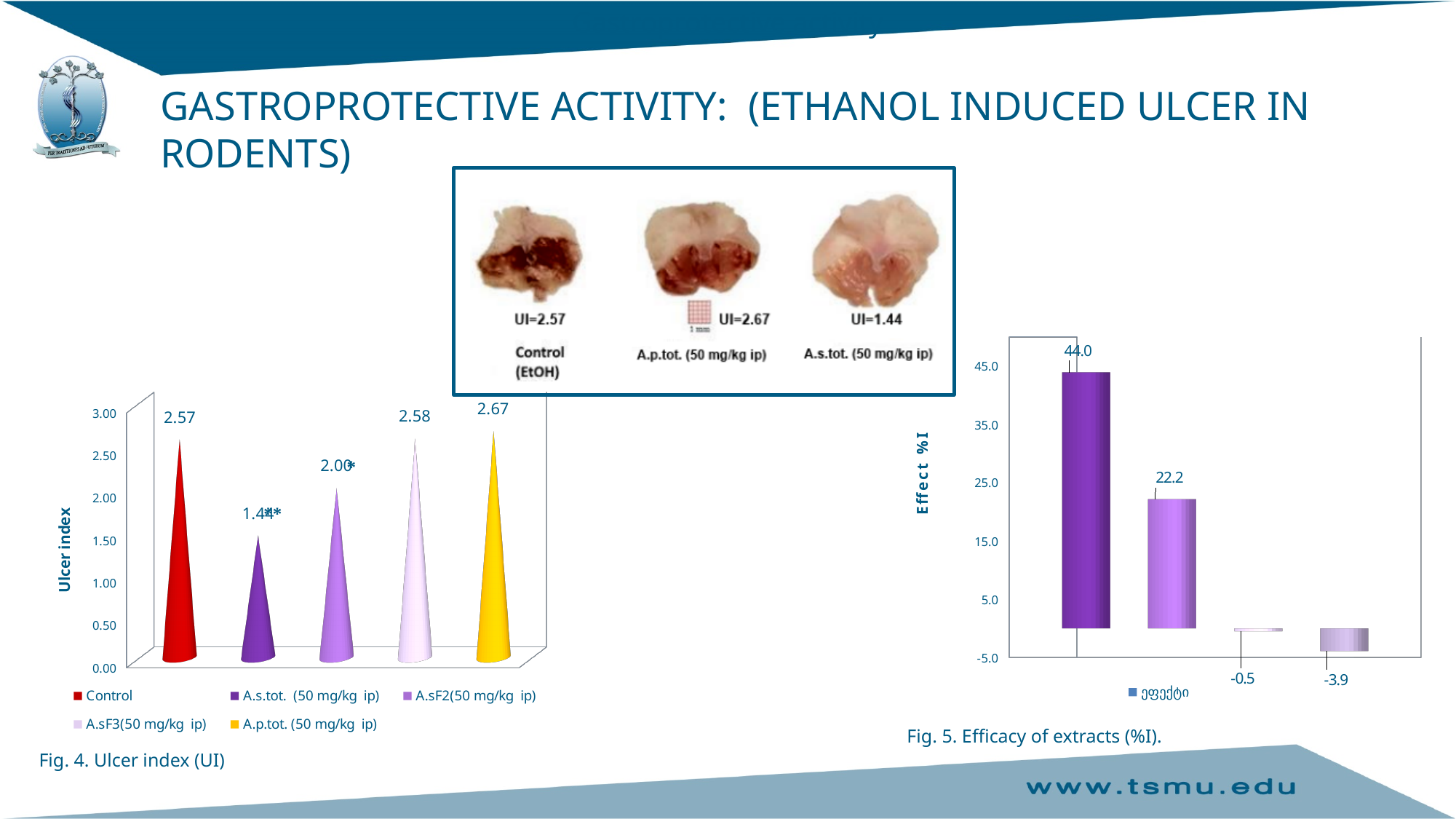
In the Fig. 5 Efficacy of extracts chart, what is the value of the last bar on the right? -3.9 In the Fig. 4 Ulcer index chart, which is larger, the ulcer index for A.sF2 (50 mg/kg ip) or for A.sF3 (50 mg/kg ip)? A.sF3 (50 mg/kg ip) In the Fig. 4 Ulcer index chart, what is the ulcer index for Control? 2.57 In the Fig. 4 Ulcer index chart, what is the difference between the ulcer index of Control and A.s.tot. (50 mg/kg ip)? 1.13 In the Fig. 4 Ulcer index chart, which group has the lowest ulcer index? A.s.tot. (50 mg/kg ip) In the Fig. 5 Efficacy of extracts chart, what is the value of the first (tallest) bar? 44.0 In the Fig. 4 Ulcer index chart, what is the ulcer index for A.p.tot. (50 mg/kg ip)? 2.67 In the Fig. 4 Ulcer index chart, which group has the highest ulcer index? A.p.tot. (50 mg/kg ip) In the Fig. 5 Efficacy of extracts chart, what is the difference between the first bar (44.0) and the second bar (22.2)? 21.8 In the Fig. 4 Ulcer index chart, how many groups are plotted? 5 In the Fig. 4 Ulcer index chart, what is the ulcer index for A.s.tot. (50 mg/kg ip)? 1.44 In the Fig. 5 Efficacy of extracts chart, what is the label of the vertical axis? Effect %I